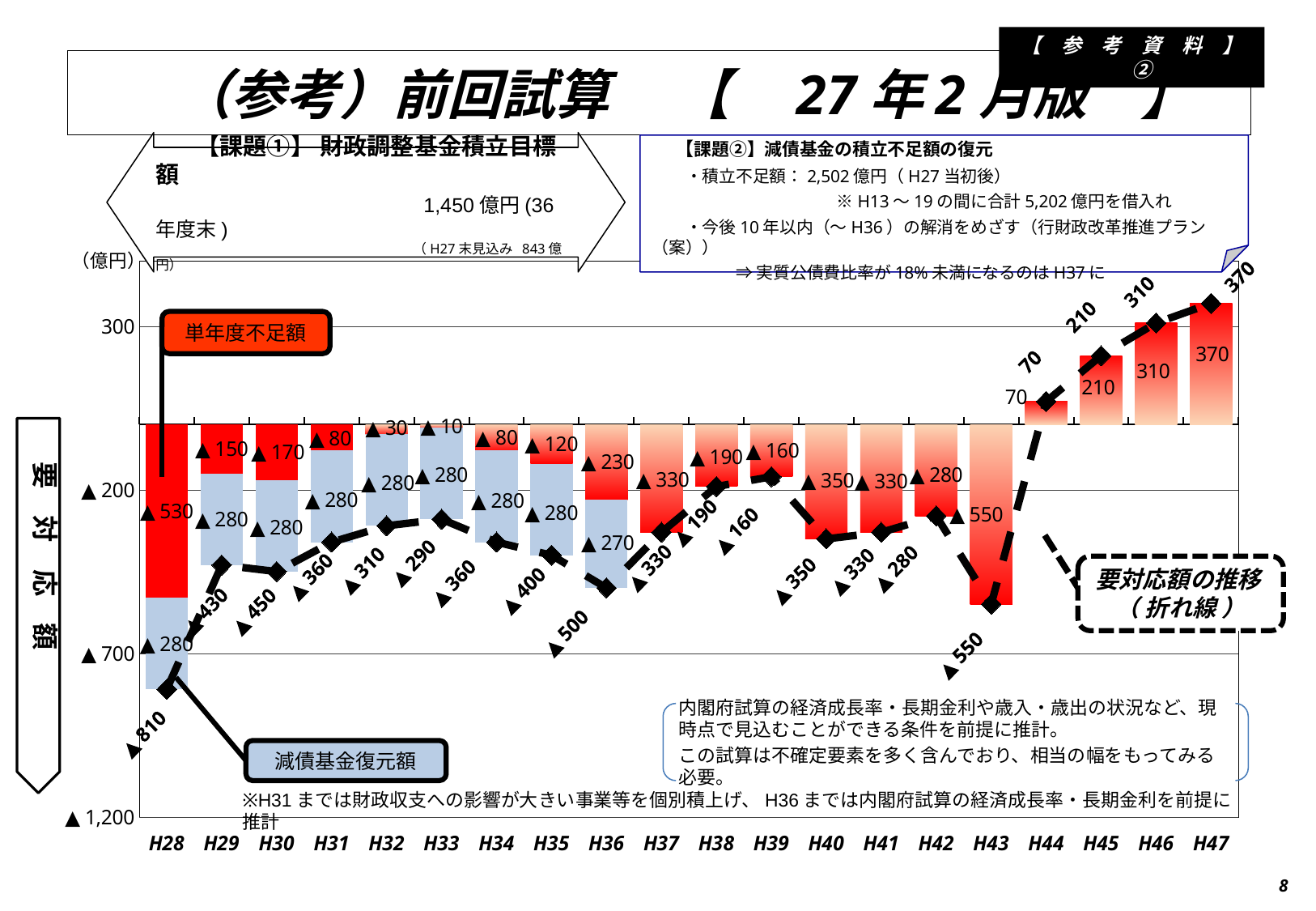
What is the 単年度不足額 (red segment) value for H28? ▲530 What does the red callout label the red bar segments as? 単年度不足額 What is the difference between the 要対応額 line values for H43 (▲550) and H42 (▲280)? 270 What is the value of the 要対応額 line for H47? 370 What is the 減債基金復元額 (blue segment) value for H36? ▲270 What is the total of the stacked bar for H29 (▲150 plus ▲280)? ▲430 What kind of chart is used to show the 要対応額の推移? A line chart over a stacked bar chart Which is larger in absolute terms, the 要対応額 line value for H36 or for H37? H36 (▲500) Which year has the largest 要対応額 deficit (the lowest point on the line)? H28 What is the value of the 要対応額 line (折れ線) for H28? ▲810 What is the 単年度不足額 value for H33? ▲10 How many fiscal years (categories) are shown on the x axis? 20